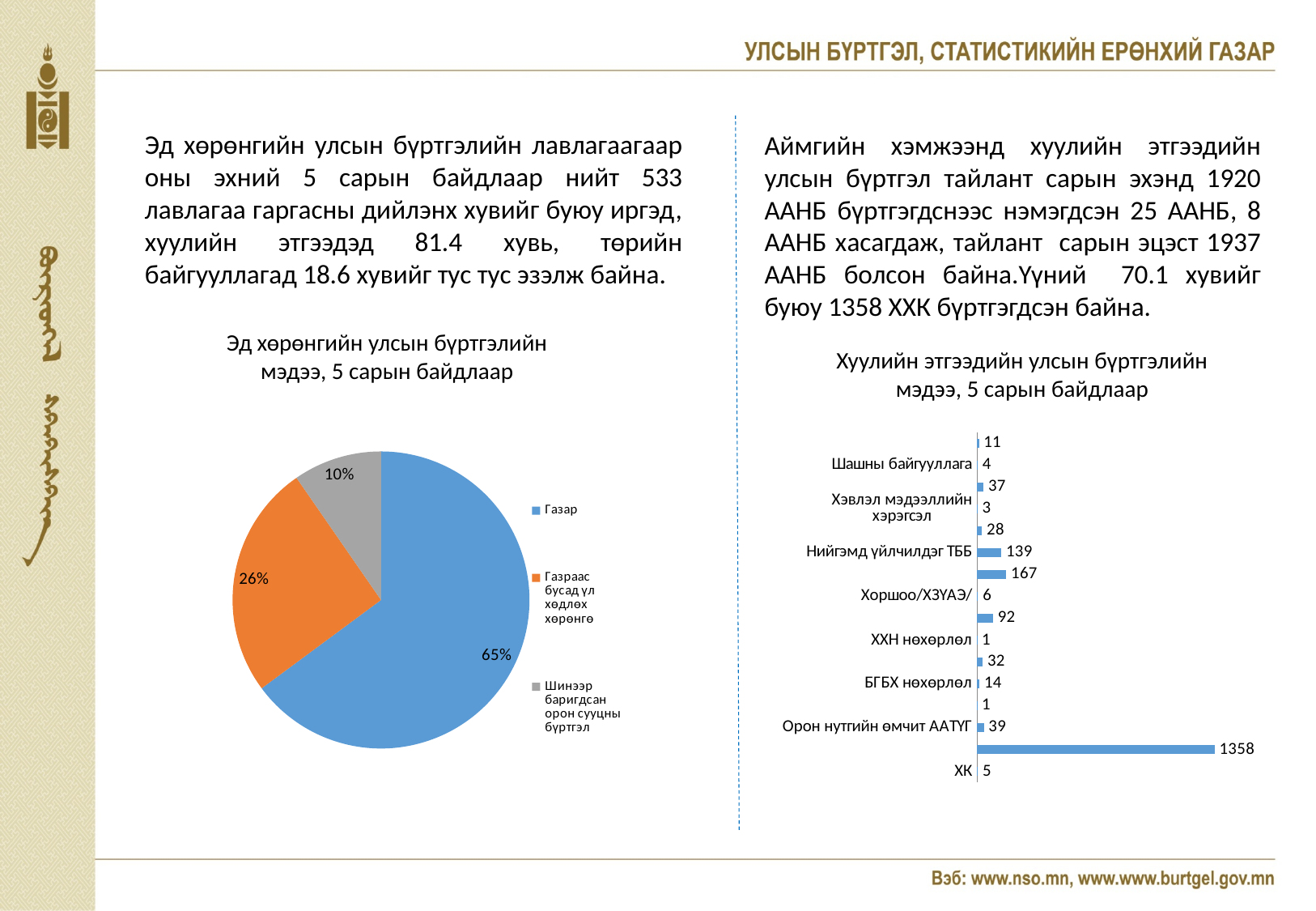
In the pie chart on the left, which category has the smallest slice? Шинээр баригдсан орон сууцны бүртгэл In the pie chart on the left, by how many percentage points does Газар exceed Газраас бусад үл хөдлөх хөрөнгө? 39 What is the title of the chart on the left of the slide? Эд хөрөнгийн улсын бүртгэлийн мэдээ, 5 сарын байдлаар In the bar chart on the right, what is the value for Нийгэмд үйлчилдэг ТББ? 139 In the bar chart on the right, how many bars are plotted? 16 In the pie chart on the left, which category has the largest slice? Газар In the pie chart on the left, what share does Газраас бусад үл хөдлөх хөрөнгө have? 26% In the bar chart on the right, what is the value for Орон нутгийн өмчит ААТҮГ? 39 In the pie chart on the left, how many slices are there? 3 In the bar chart on the right, what is the largest value shown? 1358 In the pie chart on the left, what share does Газар have? 65% What type of chart is the chart on the right of the slide? Bar chart